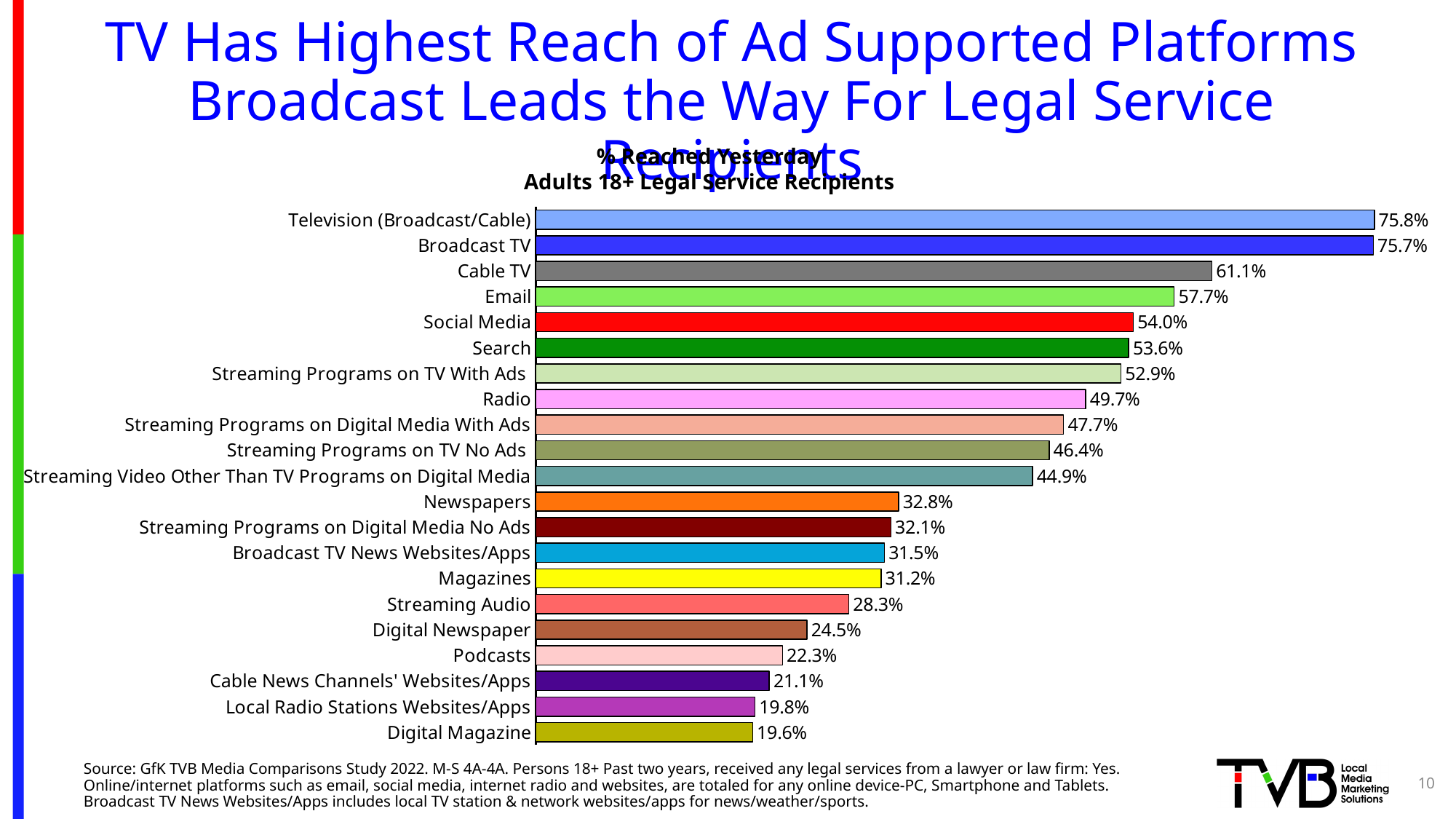
What is the value for Cable TV? 61.1% What is the difference between the values for Email and Social Media? 3.7% How many categories are shown in the chart? 21 Which has a larger value, Streaming Audio or Cable TV? Cable TV What is the value for Broadcast TV News Websites/Apps? 31.5% What is the chart's title? % Reached Yesterday Adults 18+ Legal Service Recipients What is the difference between the values for Newspapers and Digital Newspaper? 8.3% Which has a larger value, Search or Magazines? Search What is the value for Podcasts? 22.3% What kind of chart is shown on the slide? Bar chart What is the value for Radio? 49.7% What is the value for Streaming Programs on TV With Ads? 52.9%